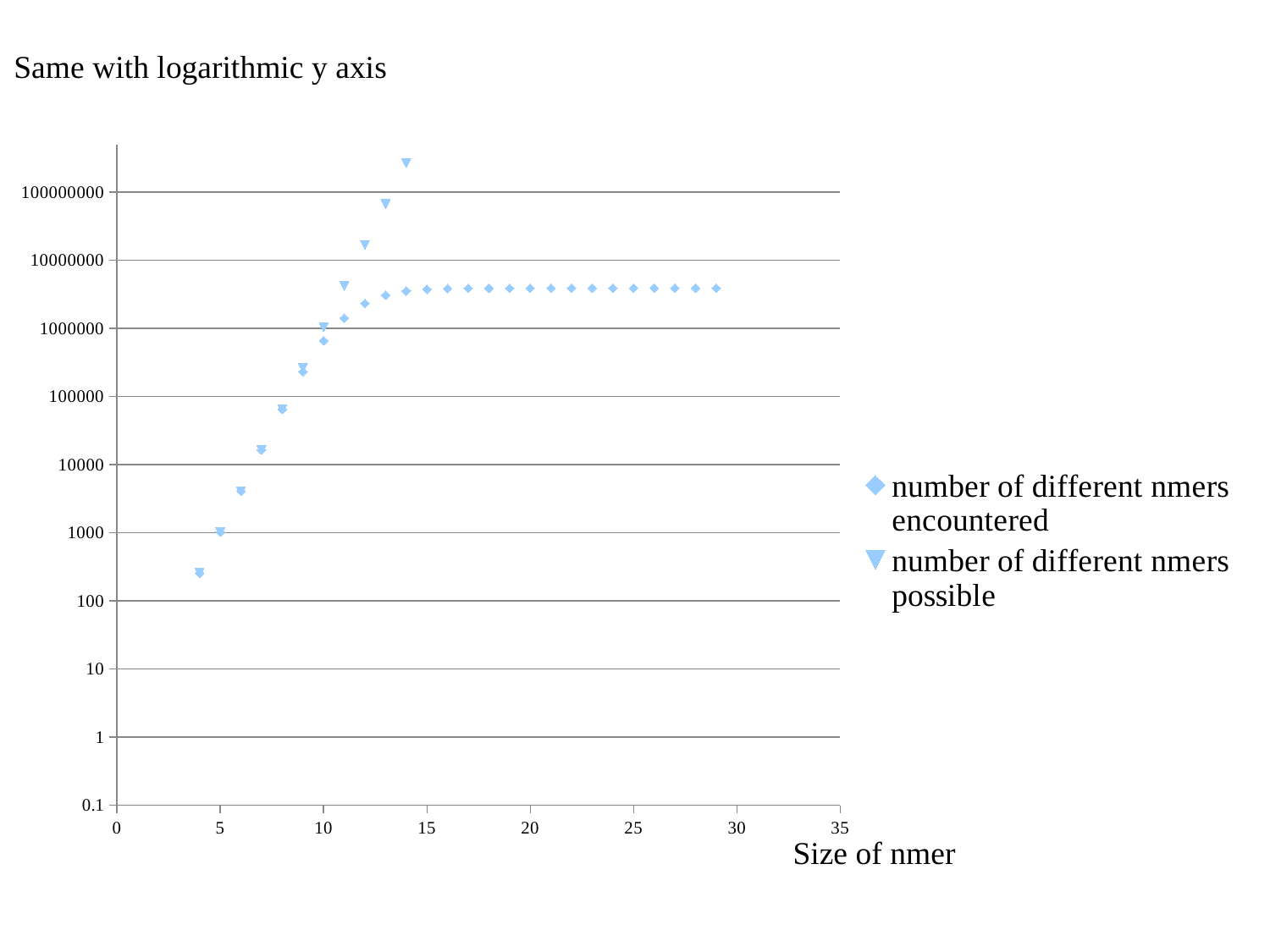
At size of nmer 14, which series has the larger value: 'number of different nmers encountered' or 'number of different nmers possible'? number of different nmers possible Is the value for 'number of different nmers encountered' at size of nmer 4 greater or less than 1000? less Which series reaches the highest value on the chart? number of different nmers possible Is the value for 'number of different nmers possible' at size of nmer 12 greater or less than 10000000? greater Is the value for 'number of different nmers encountered' at size of nmer 20 greater or less than 1000000? greater What is the label of the x axis? Size of nmer Does the 'number of different nmers possible' series rise or fall as the size of nmer increases? rise What is the title of the chart? Same with logarithmic y axis What kind of chart is shown on the slide? scatter chart How many series does the legend list? 2